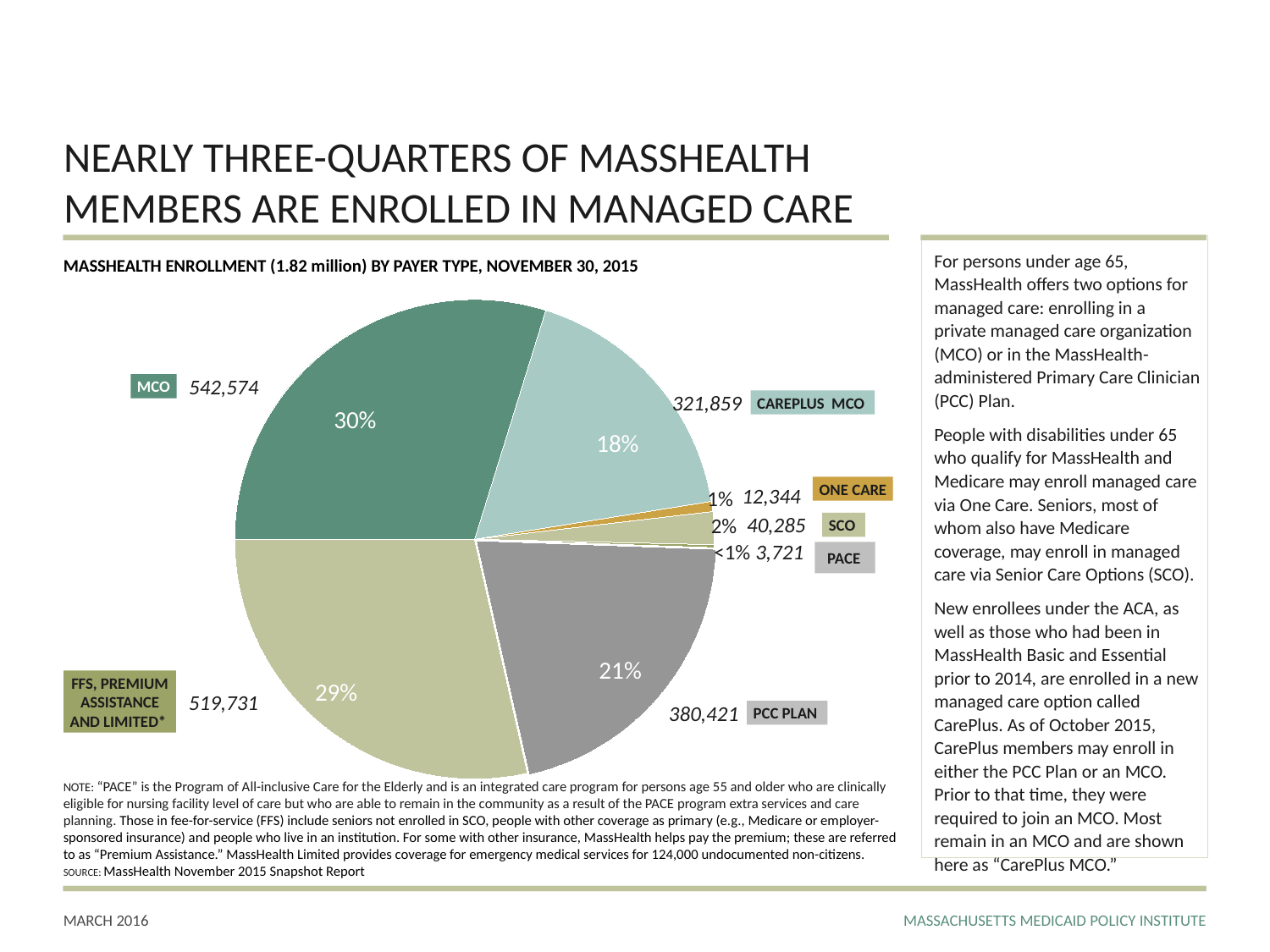
What is the difference in enrollment between MCO and PCC Plan? 162,153 How many members are enrolled in SCO? 40,285 Which payer type has the smallest number of enrollees? PACE How many payer types are shown in the pie chart? 7 How many MassHealth members are enrolled in an MCO? 542,574 What percentage of enrollment is in FFS, Premium Assistance and Limited? 29% Which has more enrollees, SCO or One Care? SCO What is the title of the chart? MASSHEALTH ENROLLMENT (1.82 million) BY PAYER TYPE, NOVEMBER 30, 2015 What share of MassHealth enrollment is in the PCC Plan? 21% How many members are enrolled in CarePlus MCO? 321,859 What type of chart is shown on the slide? Pie chart Which payer type has the largest share of MassHealth enrollment? MCO